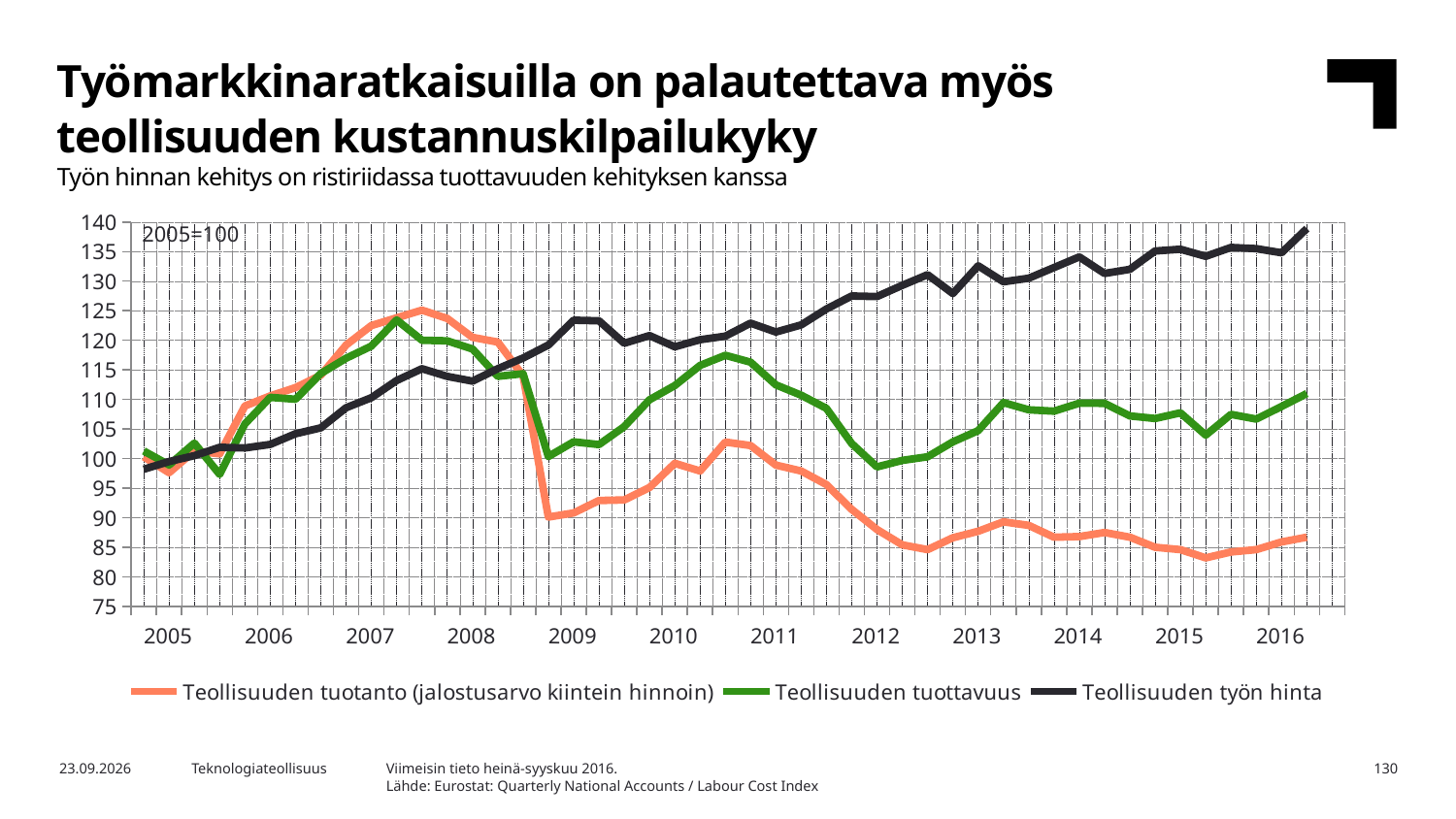
Is the value for Teollisuuden tuottavuus at the end of 2016 greater or less than 105? greater Is the value for Teollisuuden työn hinta in 2012 greater or less than 125? greater Is the value for Teollisuuden työn hinta at the end of 2016 greater or less than 135? greater What kind of chart is shown on the slide? line chart Which series is highest at the end of 2016? Teollisuuden työn hinta How many years are labelled on the x axis? 12 What base year and index value is noted in the top-left corner of the chart? 2005=100 How many series does the legend list? 3 Does the Teollisuuden työn hinta series rise or fall overall from 2005 to 2016? rise At the end of 2016, which is larger: Teollisuuden työn hinta or Teollisuuden tuotanto (jalostusarvo kiintein hinnoin)? Teollisuuden työn hinta Which series is lowest at the end of 2016? Teollisuuden tuotanto (jalostusarvo kiintein hinnoin)